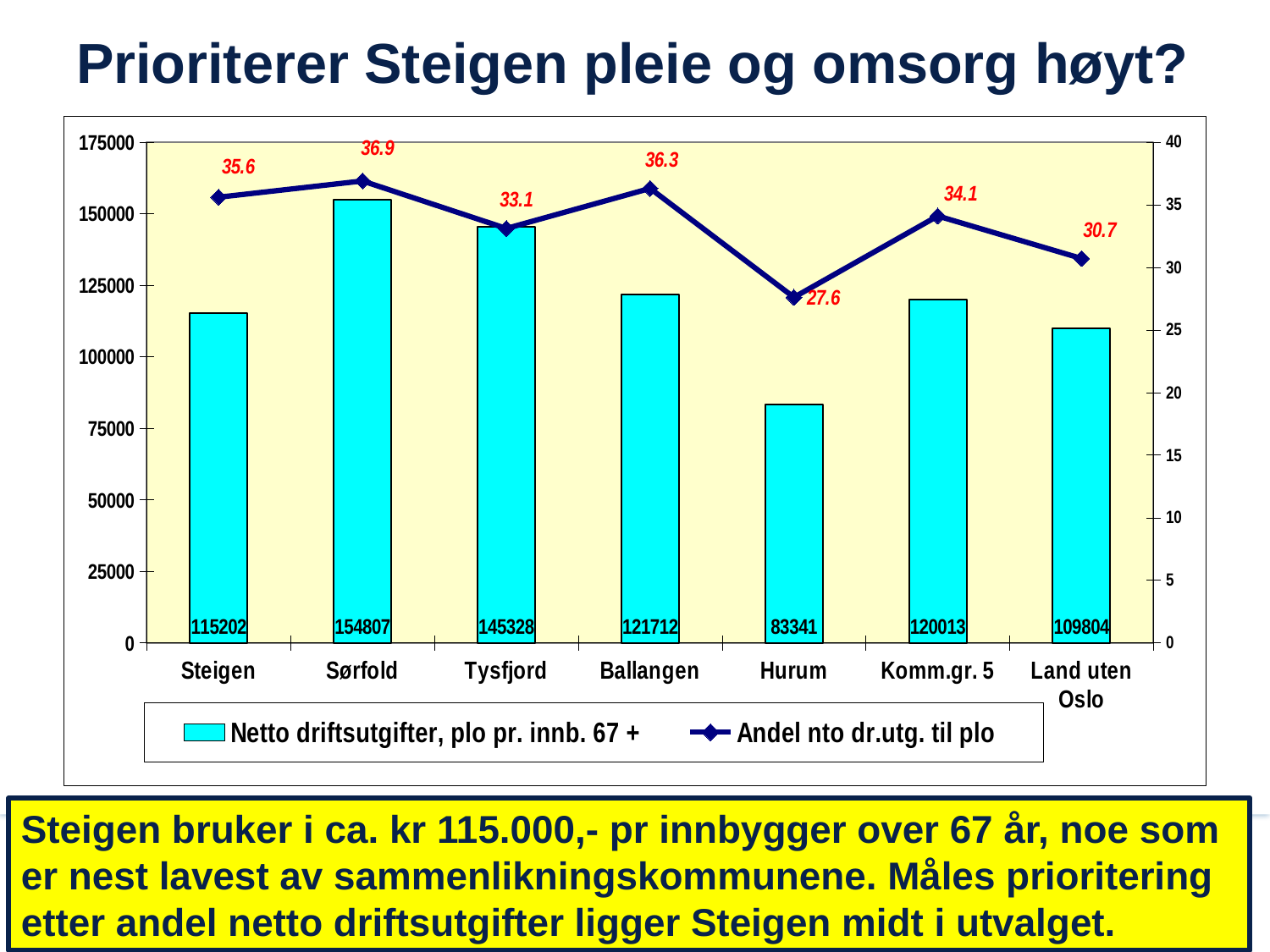
Which has a higher Andel nto dr.utg. til plo, Ballangen or Tysfjord? Ballangen Which category has the lowest Andel nto dr.utg. til plo? Hurum What is the value of Netto driftsutgifter, plo pr. innb. 67 + for Steigen? 115202 What kind of chart is shown on the slide? Combined bar and line chart Which category has the highest Netto driftsutgifter, plo pr. innb. 67 +? Sørfold Which category has the highest Andel nto dr.utg. til plo? Sørfold What is the difference in Andel nto dr.utg. til plo between Komm.gr. 5 and Land uten Oslo? 3.4 How many series does the legend list? 2 What is the value of Netto driftsutgifter, plo pr. innb. 67 + for Land uten Oslo? 109804 What is the value of Andel nto dr.utg. til plo for Hurum? 27.6 What is the difference in Netto driftsutgifter, plo pr. innb. 67 + between Sørfold and Steigen? 39605 How many categories are shown on the x axis? 7